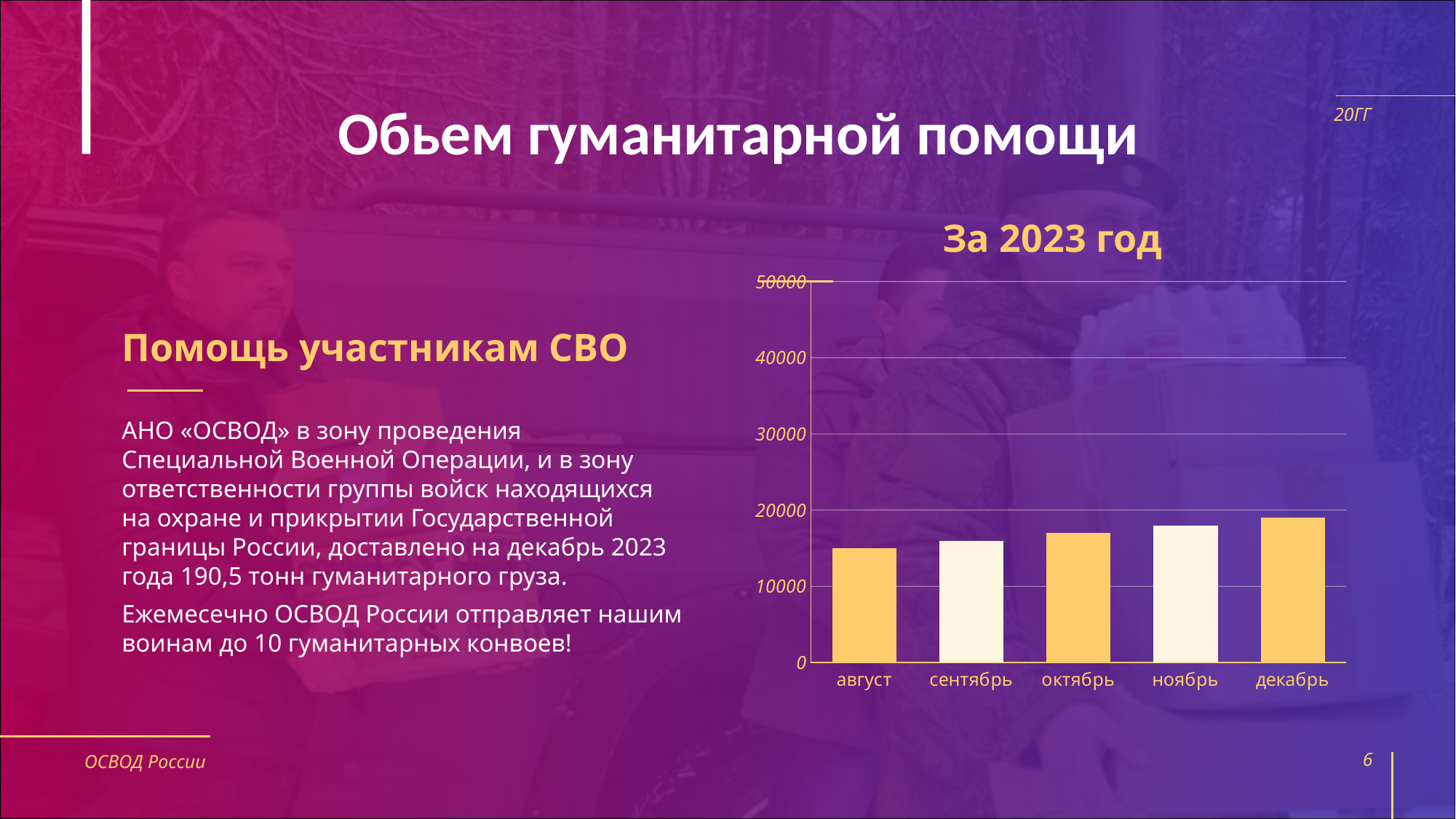
Do the values rise or fall from август to декабрь? rise What kind of chart is shown on the slide? bar chart Is the value for декабрь greater or less than 20000? less What is the title of the chart? За 2023 год Which month has the lowest bar on the chart? август Which is larger, the value for сентябрь or the value for ноябрь? ноябрь Which is larger, the value for декабрь or the value for август? декабрь Which month has the highest bar on the chart? декабрь Is the value for октябрь greater or less than 30000? less Is the value for август greater or less than 10000? greater How many months are plotted on the chart? 5 What is the highest value shown on the vertical axis of the chart? 50000